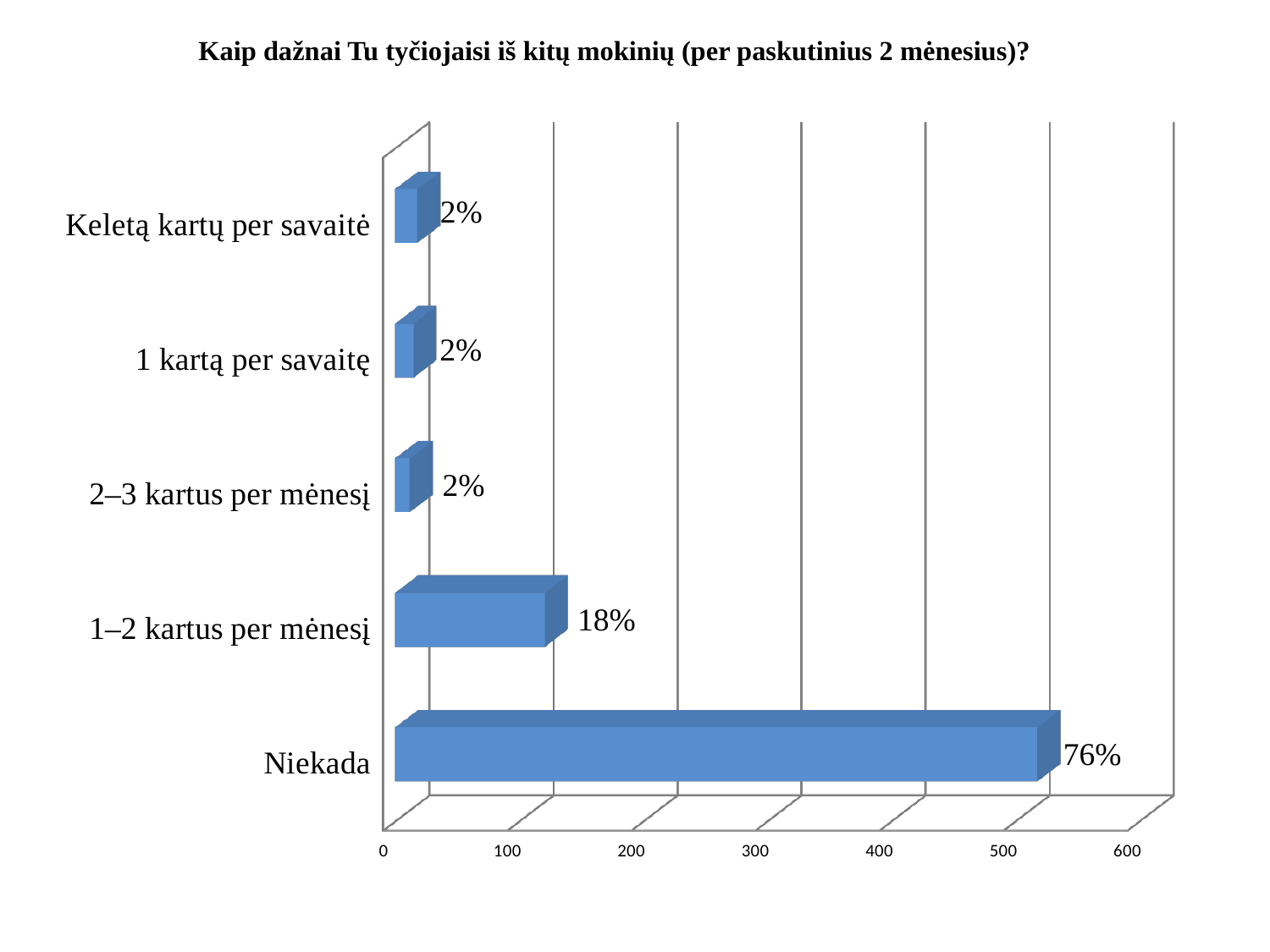
What is the title of the chart? Kaip dažnai Tu tyčiojaisi iš kitų mokinių (per paskutinius 2 mėnesius)? How many categories are shown in the chart? 5 On the horizontal axis, is the bar for "1–2 kartus per mėnesį" greater or less than 100? greater What data label is shown for the "2–3 kartus per mėnesį" bar? 2% What data label is shown for the "Niekada" bar? 76% What is the difference between the data labels for "Niekada" and "1–2 kartus per mėnesį"? 58% Which is larger, the value for "1–2 kartus per mėnesį" or the value for "1 kartą per savaitę"? 1–2 kartus per mėnesį On the horizontal axis, is the bar for "Niekada" greater or less than 500? greater What data label is shown for the "Keletą kartų per savaitė" bar? 2% What data label is shown for the "1–2 kartus per mėnesį" bar? 18% What kind of chart is shown on the slide? Bar chart Which category has the highest value? Niekada